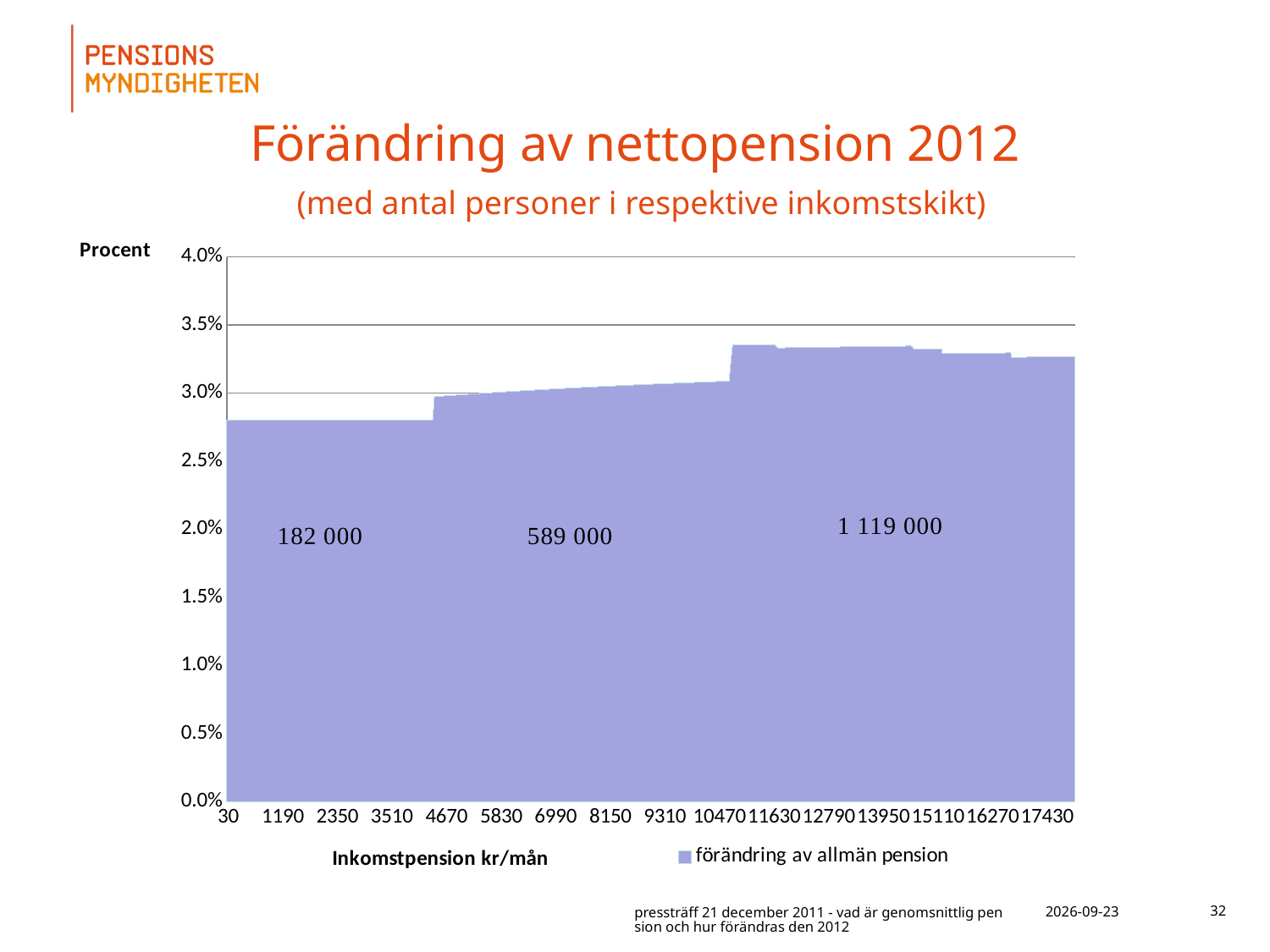
Is the value for an inkomstpension of 11630 kr/mån greater or less than 3.0%? greater Is the value for an inkomstpension of 30 kr/mån greater or less than 3.0%? less Do the values generally rise or fall as inkomstpension increases from 30 to 17430 kr/mån? rise Is the value for an inkomstpension of 11630 kr/mån greater or less than 3.5%? less How many series does the legend list? 1 How many persons are shown for the highest income bracket group on the chart? 1 119 000 What kind of chart is shown on the slide? area chart What is the name of the series shown in the legend? förändring av allmän pension What is the title of the chart? Förändring av nettopension 2012 Which is larger, the value at 2350 kr/mån or the value at 12790 kr/mån? 12790 kr/mån